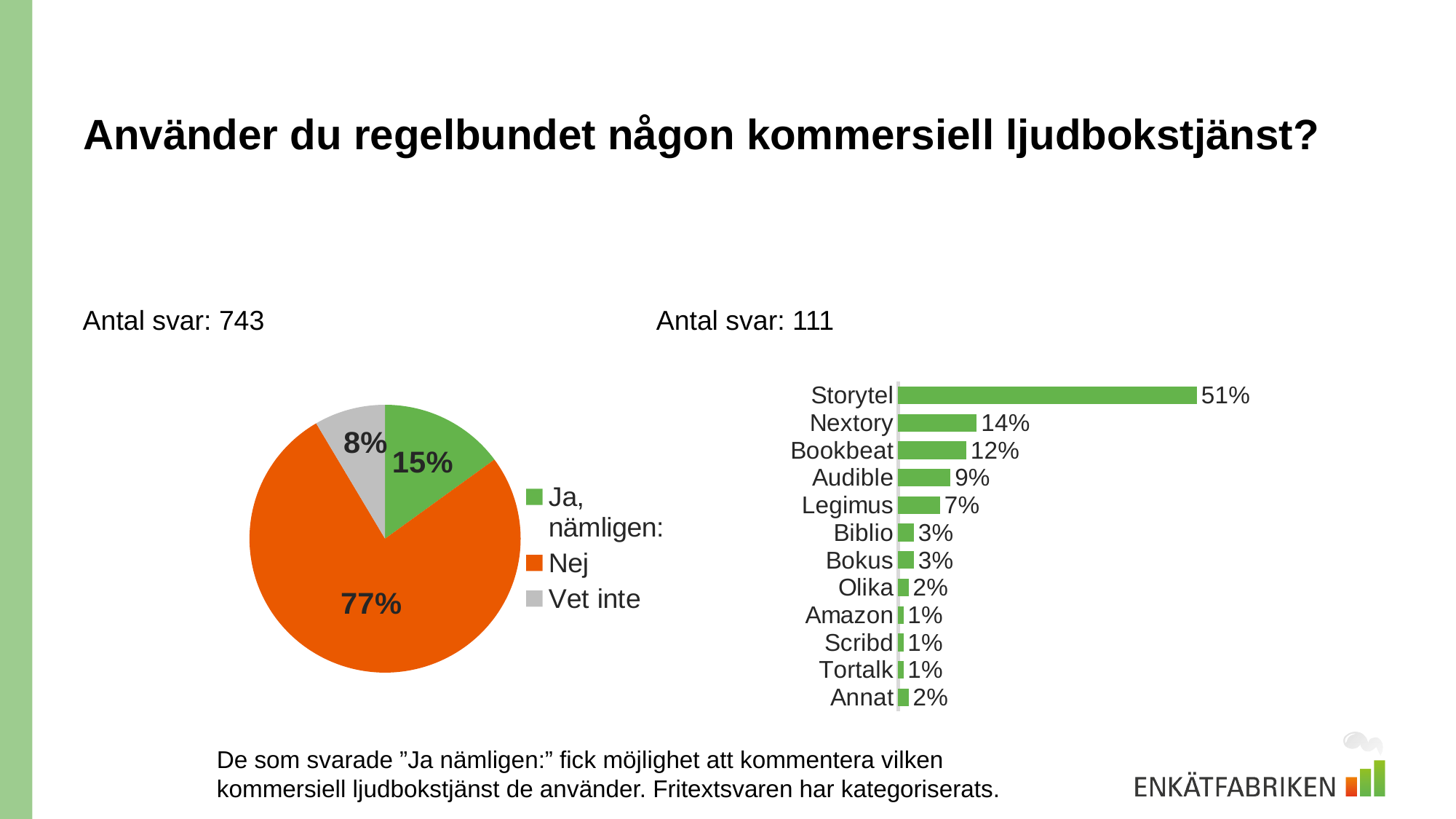
In the bar chart on the right, which service has the highest value? Storytel In the bar chart on the right, what is the value for Legimus? 7% In the bar chart on the right, what is the value for Storytel? 51% In the pie chart on the left, what share of respondents answered "Vet inte"? 8% In the pie chart on the left, how many slices are there? 3 In the pie chart on the left, what share of respondents answered "Nej"? 77% What kind of chart is the chart on the right? Bar chart In the pie chart on the left, which answer has the smallest slice? Vet inte What kind of chart is the chart on the left? Pie chart In the bar chart on the right, how many categories are shown? 12 In the bar chart on the right, which is larger, Audible or Legimus? Audible In the bar chart on the right, what is the difference between Nextory and Bookbeat? 2%